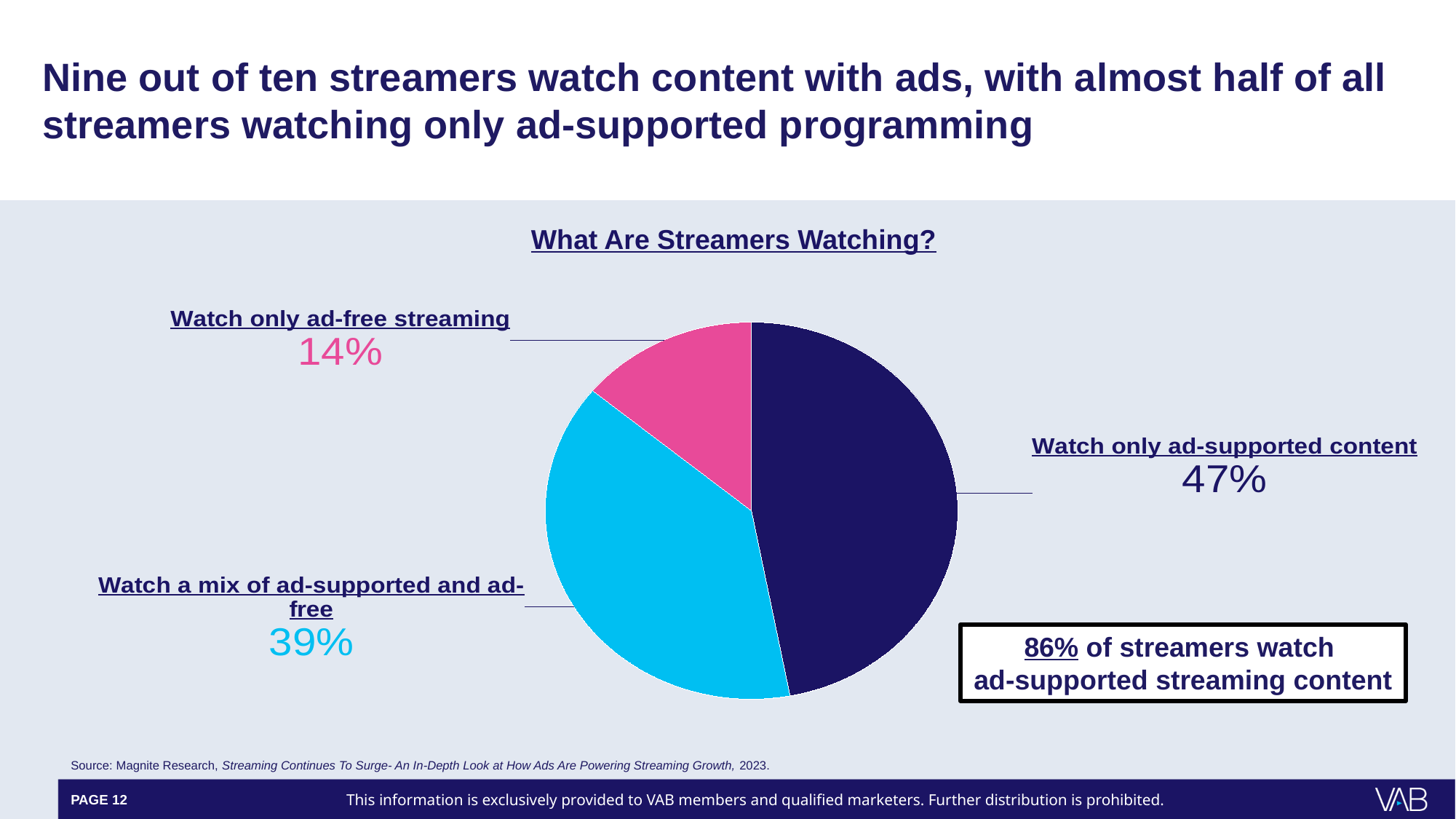
What share of streamers watch only ad-supported content? 47% Which category has the largest slice of the pie? Watch only ad-supported content What is the title of the chart? What Are Streamers Watching? What colour is the slice for 'Watch only ad-free streaming'? Pink Which is larger: the share that watches only ad-free streaming or the share that watches a mix of ad-supported and ad-free? Watch a mix of ad-supported and ad-free What is the difference in percentage points between 'Watch only ad-supported content' and 'Watch a mix of ad-supported and ad-free'? 8 percentage points What share of streamers watch a mix of ad-supported and ad-free? 39% What kind of chart is shown on the slide? Pie chart What is the difference in percentage points between 'Watch a mix of ad-supported and ad-free' and 'Watch only ad-free streaming'? 25 percentage points How many slices does the pie chart have? 3 Which category has the smallest slice of the pie? Watch only ad-free streaming What share of streamers watch only ad-free streaming? 14%